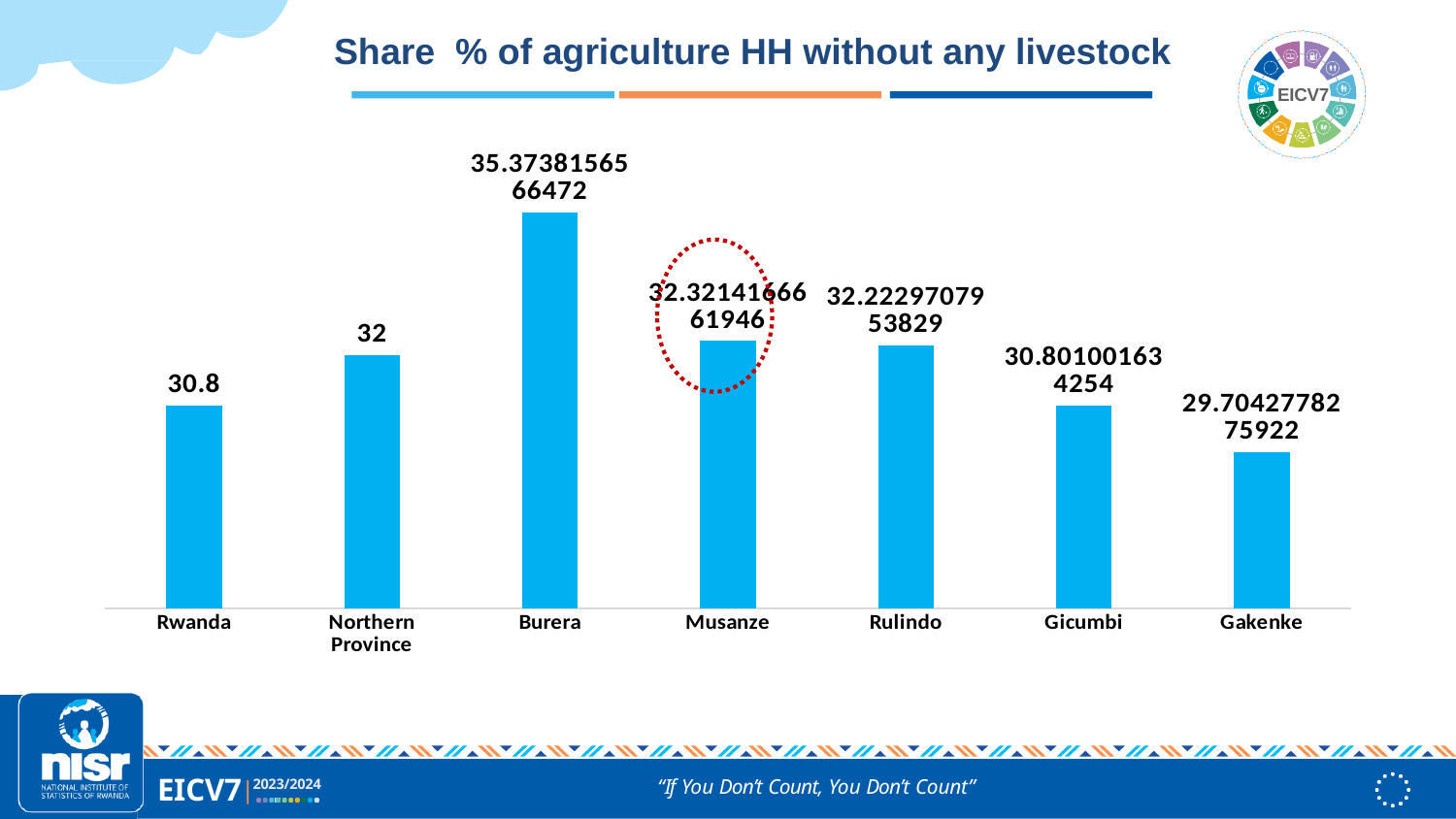
Which category has the highest share of agriculture households without any livestock? Burera What is the value shown for Gakenke? 29.7042778275922 What is the value for Rwanda? 30.8 How many categories are shown on the x axis? 7 Which is larger, the value for Rwanda or the value for Northern Province? Northern Province What is the difference between the values for Northern Province and Rwanda? 1.2 What is the value for Northern Province? 32 What kind of chart is shown on the slide? Bar chart Which category has the lowest value in the chart? Gakenke Which category's data label is highlighted with a red dotted circle? Musanze What is the value shown for Burera? 35.3738156566472 Which is larger, the value for Burera or the value for Gicumbi? Burera